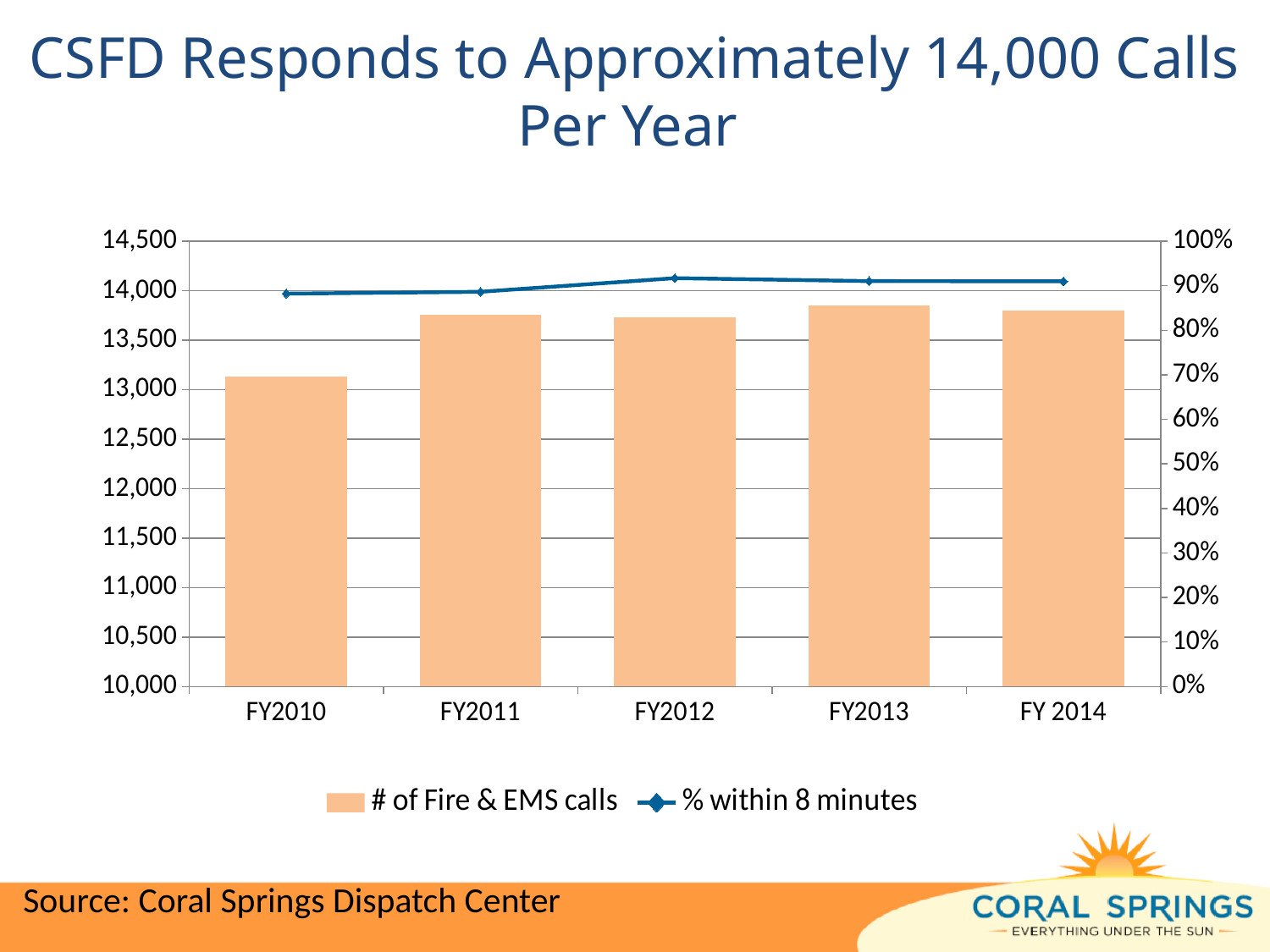
Which series is plotted as a line in the chart? % within 8 minutes Is the number of Fire & EMS calls for FY2010 greater or less than 13,500? less Which fiscal year has the lowest number of Fire & EMS calls? FY2010 Is the number of Fire & EMS calls for FY2013 greater or less than 14,000? less Is the % within 8 minutes for FY2012 greater or less than 80%? greater Which has more Fire & EMS calls, FY2010 or FY2011? FY2011 How many fiscal years are shown on the x axis of the chart? 5 Which has more Fire & EMS calls, FY2010 or FY2013? FY2013 Did the number of Fire & EMS calls rise or fall from FY2010 to FY2011? rise How many series does the chart's legend list? 2 What kind of chart is shown on the slide? A combined bar and line chart